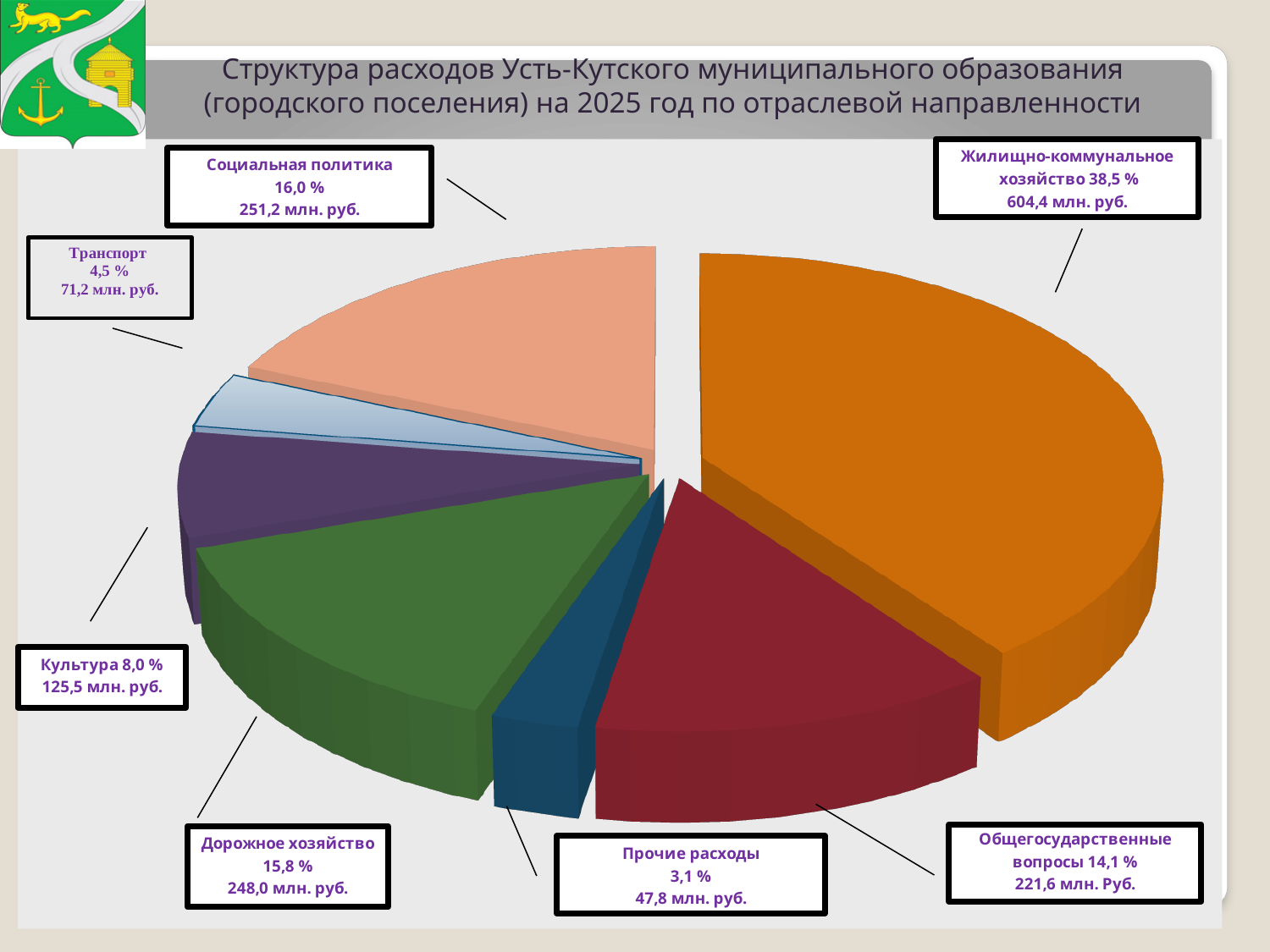
What share of expenditures goes to Культура? 8,0 % What share of expenditures goes to Жилищно-коммунальное хозяйство? 38,5 % What is the amount in million rubles for Прочие расходы? 47,8 млн. руб. What is the difference in percentage points between Социальная политика and Дорожное хозяйство? 0,2 % What is the amount in million rubles for Социальная политика? 251,2 млн. руб. What is the amount in million rubles for Транспорт? 71,2 млн. руб. How many slices does the pie chart have? 7 What kind of chart is shown on the slide? pie chart What year does the chart title say the expenditure structure refers to? 2025 Which category has the largest share of expenditures? Жилищно-коммунальное хозяйство Which category has the smallest share of expenditures? Прочие расходы Which is larger in million rubles: Общегосударственные вопросы or Культура? Общегосударственные вопросы